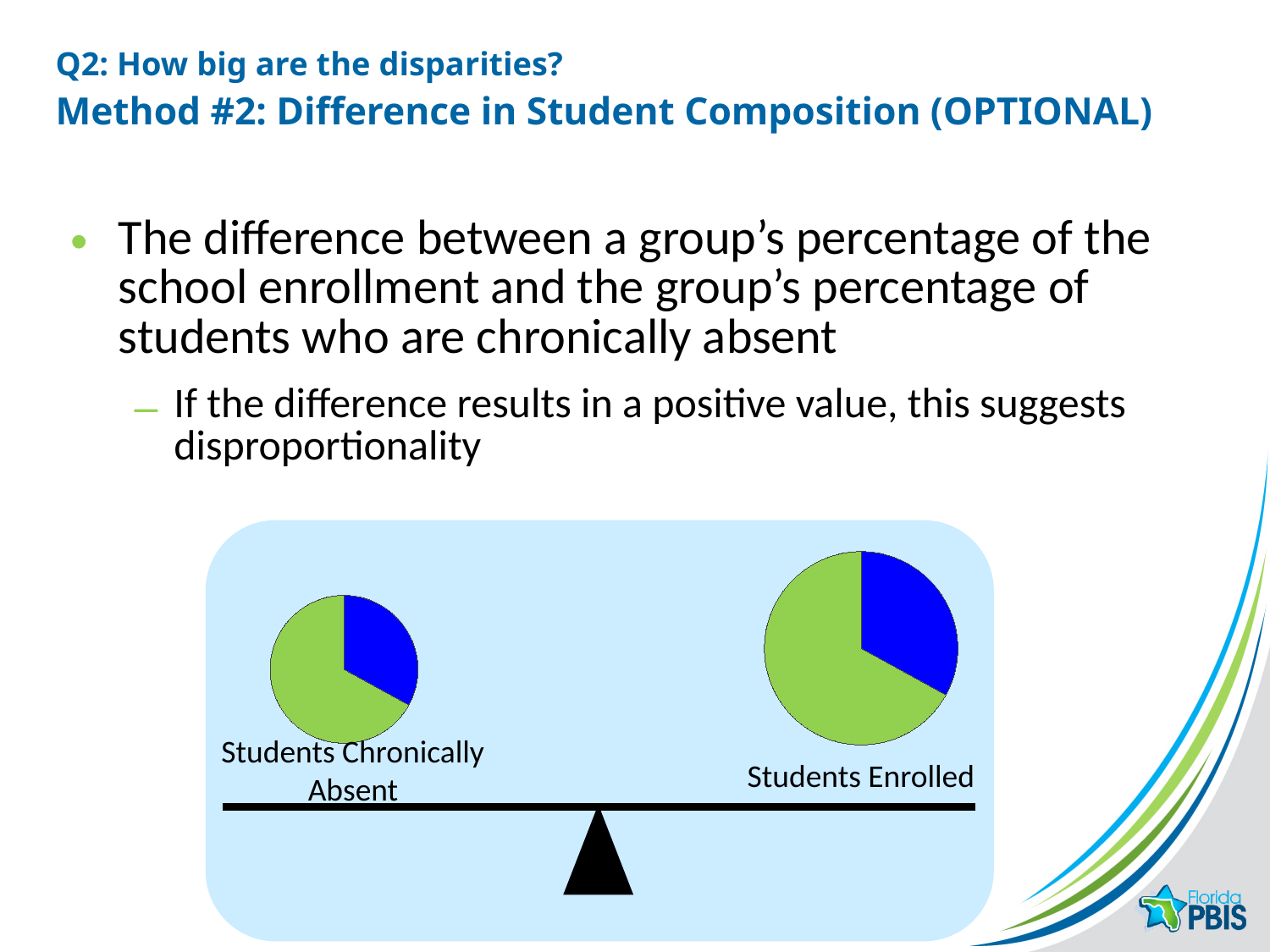
How many slices does the "Students Chronically Absent" pie chart have? 2 How many slices does the "Students Enrolled" pie chart have? 2 In the "Students Chronically Absent" pie chart, which slice is larger, the green one or the blue one? green In the "Students Enrolled" pie chart, which slice is larger, the green one or the blue one? green What kind of chart is the "Students Chronically Absent" chart? pie chart In the "Students Chronically Absent" pie chart, which slice is the smallest? blue What kind of chart is the "Students Enrolled" chart? pie chart What is the title of the pie chart on the left side of the balance? Students Chronically Absent What is the title of the pie chart on the right side of the balance? Students Enrolled How many pie charts are shown on the slide? 2 In the "Students Enrolled" pie chart, which slice is the largest? green